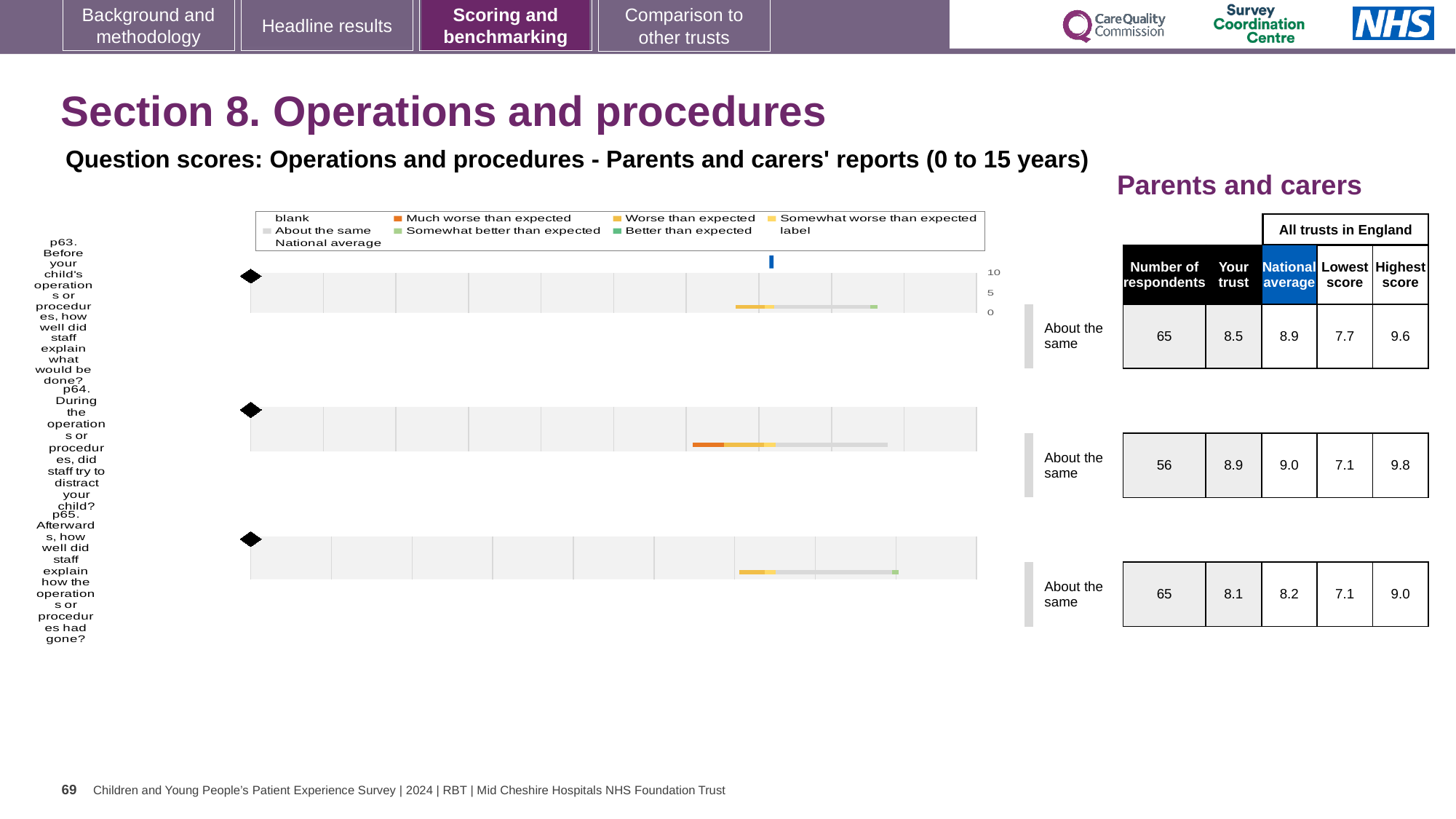
For question p63 (how well staff explained what would be done before the operation), what is the 'Your trust' score? 8.5 What benchmark category is shown for question p65? About the same What is the lowest score among all trusts in England for question p63? 7.7 What kind of chart is used to show the question scores on this slide? bar chart Which of the three questions has the highest 'Your trust' score? p64 For question p65 (how well staff explained how the operation had gone), what is the highest score among all trusts in England? 9.0 For question p63, what is the difference between the national average and the 'Your trust' score? 0.4 For question p64, which is larger: the 'Your trust' score or the national average? National average For question p64 (did staff try to distract your child during the operation), what is the national average score? 9.0 Which of the three questions has the lowest 'Your trust' score? p65 How many respondents answered question p64? 56 How many questions (p63, p64, p65) are plotted on this slide? 3